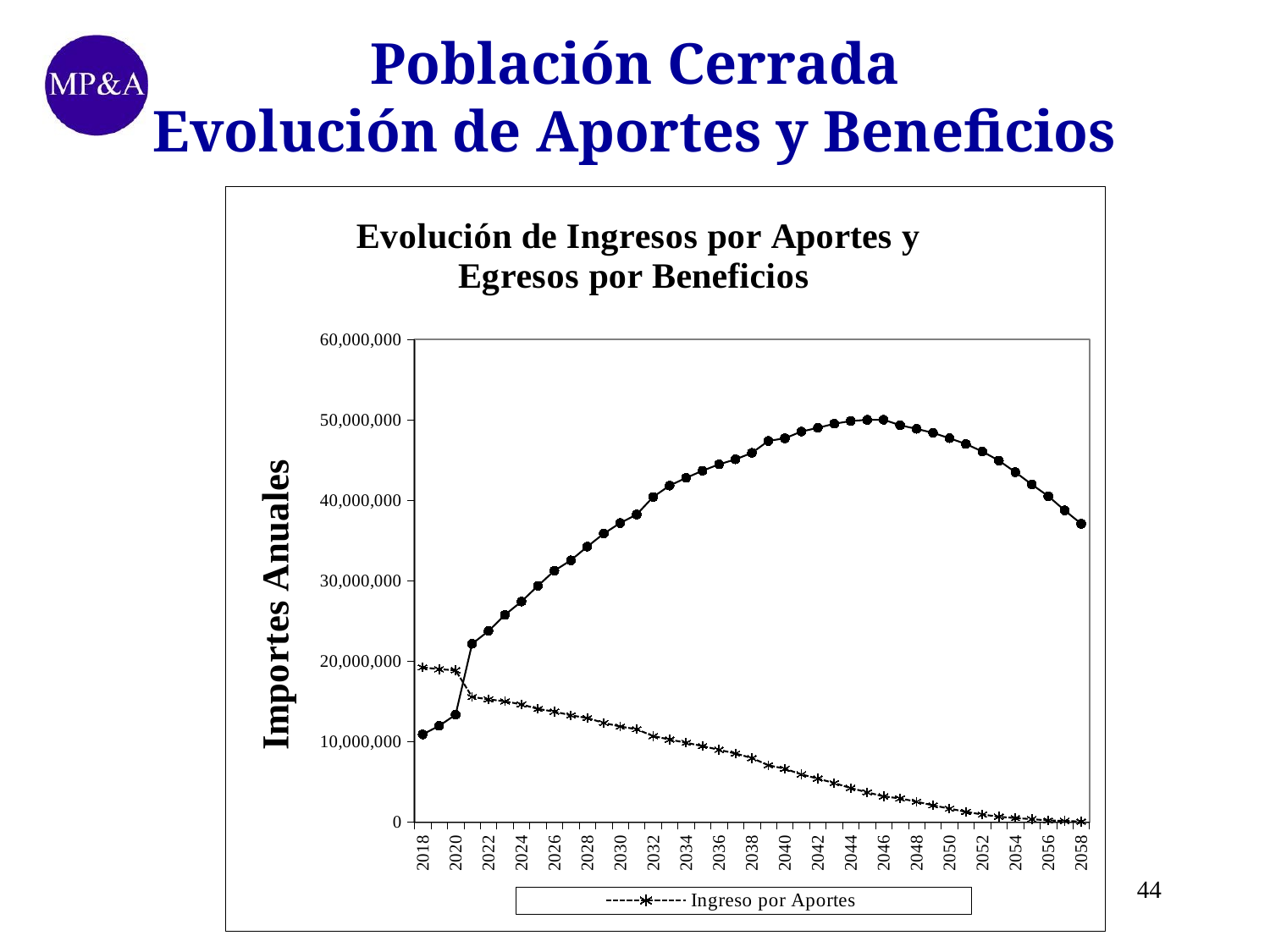
What is the last year shown on the horizontal axis of the chart? 2058 What is the title of the chart? Evolución de Ingresos por Aportes y Egresos por Beneficios Is the value of the solid line with circle markers in 2044 greater or less than 40,000,000? greater What kind of chart is shown on the slide? Line chart In 2018, which series has the higher value: Ingreso por Aportes or the solid line with circle markers? Ingreso por Aportes Does the Ingreso por Aportes series rise or fall from 2022 to 2058? Fall Is the value for Ingreso por Aportes in 2040 greater or less than 10,000,000? less Is the value for Ingreso por Aportes in 2018 greater or less than 10,000,000? greater In 2058, which series has the higher value: Ingreso por Aportes or the solid line with circle markers? The solid line with circle markers What is the label on the vertical axis of the chart? Importes Anuales